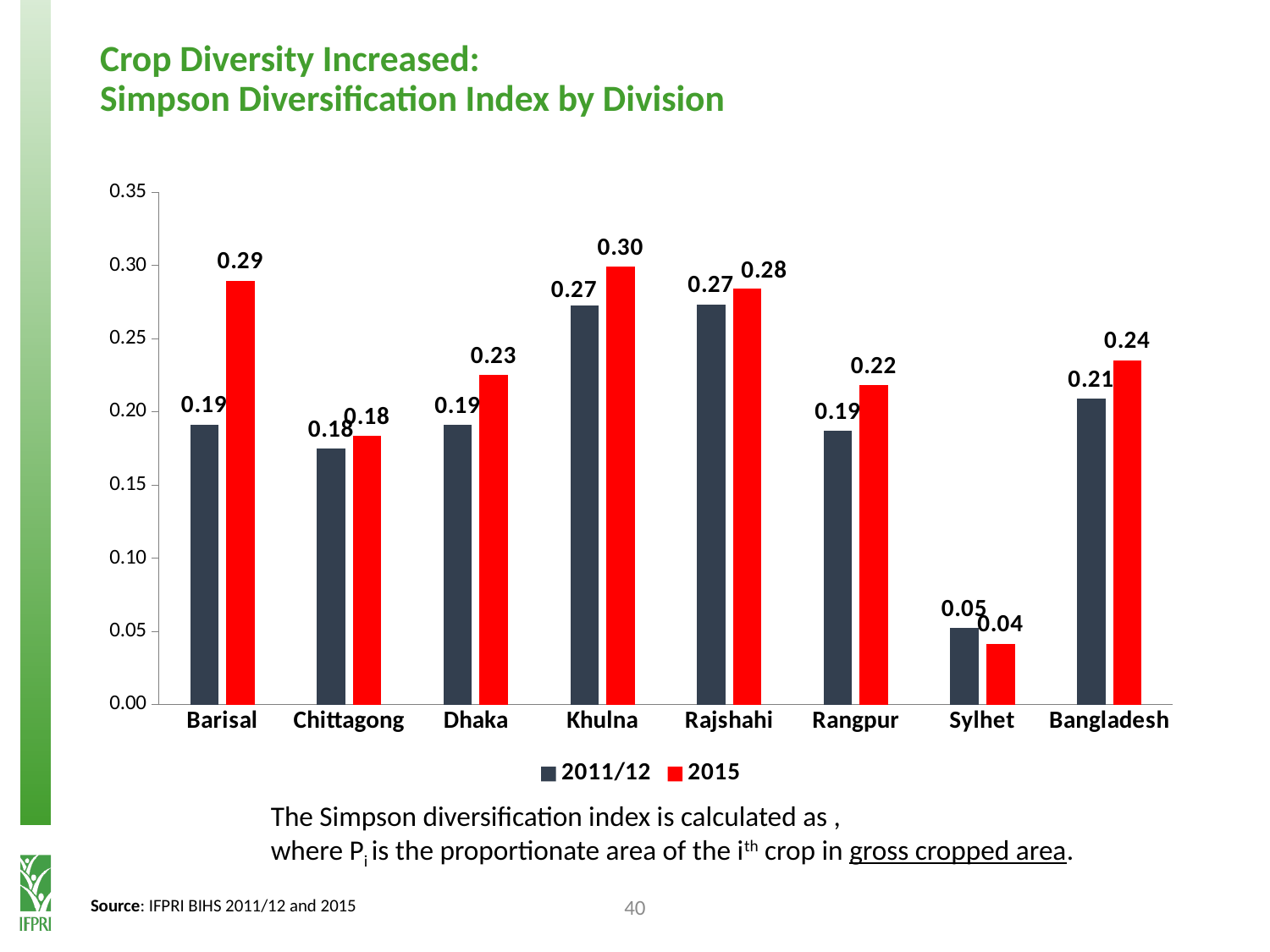
By how much did Barisal's index increase from 2011/12 to 2015? 0.10 What is the Simpson Diversification Index for Khulna in 2011/12? 0.27 What kind of chart is shown on the slide? bar chart What is the value for Bangladesh in 2015? 0.24 How many categories are shown on the x axis? 8 What is the Simpson Diversification Index for Barisal in 2015? 0.29 Is the 2015 value for Khulna greater or less than 0.25? greater What are the two series named in the legend? 2011/12 and 2015 Which division has the highest value in 2015? Khulna Which division has the lowest value in 2011/12? Sylhet Which is larger, the 2015 value for Dhaka or the 2015 value for Rangpur? Dhaka How many series does the legend list? 2